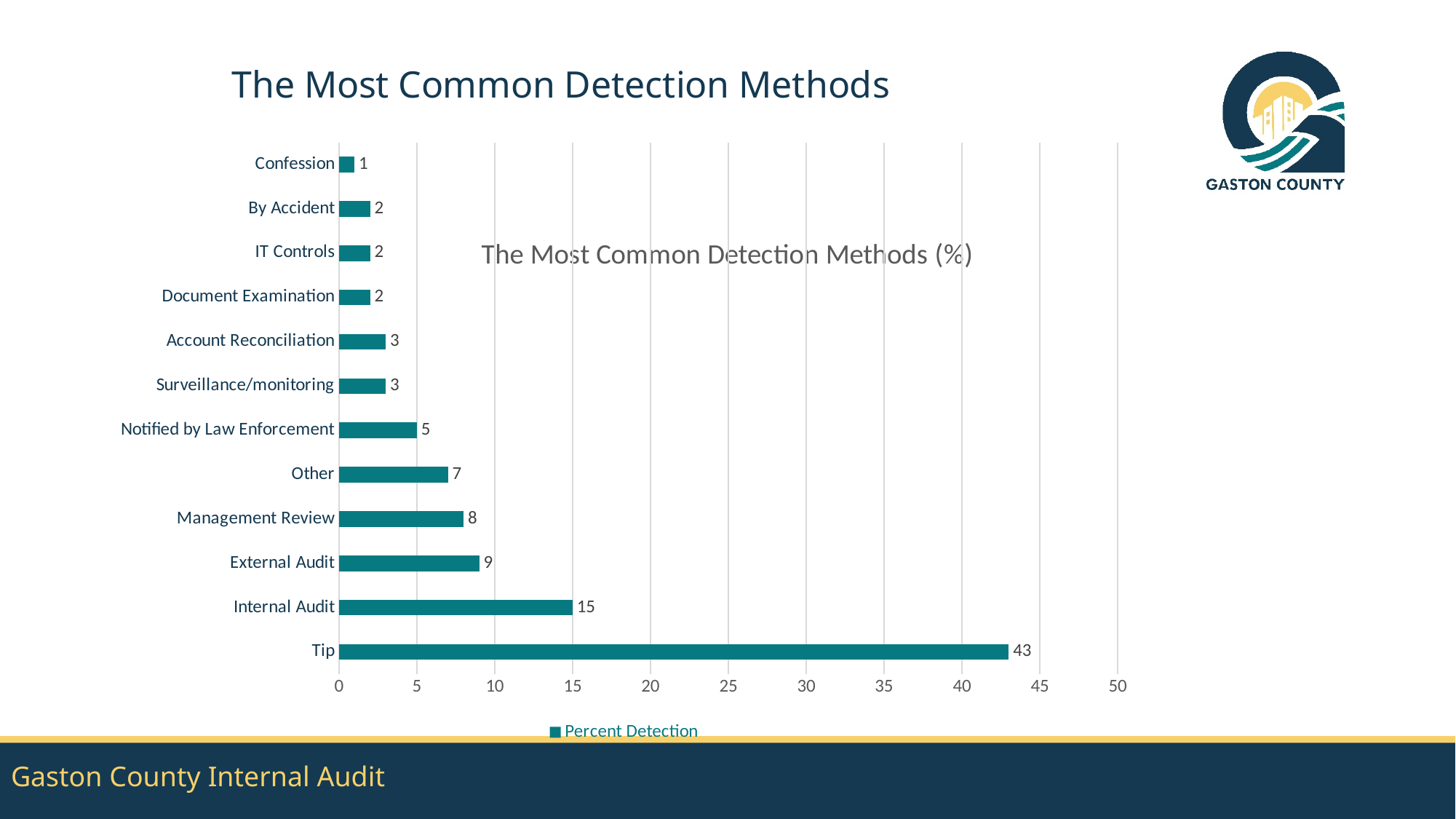
Is the value for Tip greater or less than 40? greater What is the value for Notified by Law Enforcement? 5 What is the difference between the values for Tip and Internal Audit? 28 Which detection method has the highest value? Tip How many series does the legend list? 1 Which is larger, the value for External Audit or the value for Management Review? External Audit What is the title of the chart? The Most Common Detection Methods (%) What is the value for Tip? 43 What kind of chart is shown on the slide? Bar chart How many detection methods are shown on the chart? 12 Which detection method has the lowest value? Confession What is the value for Internal Audit? 15